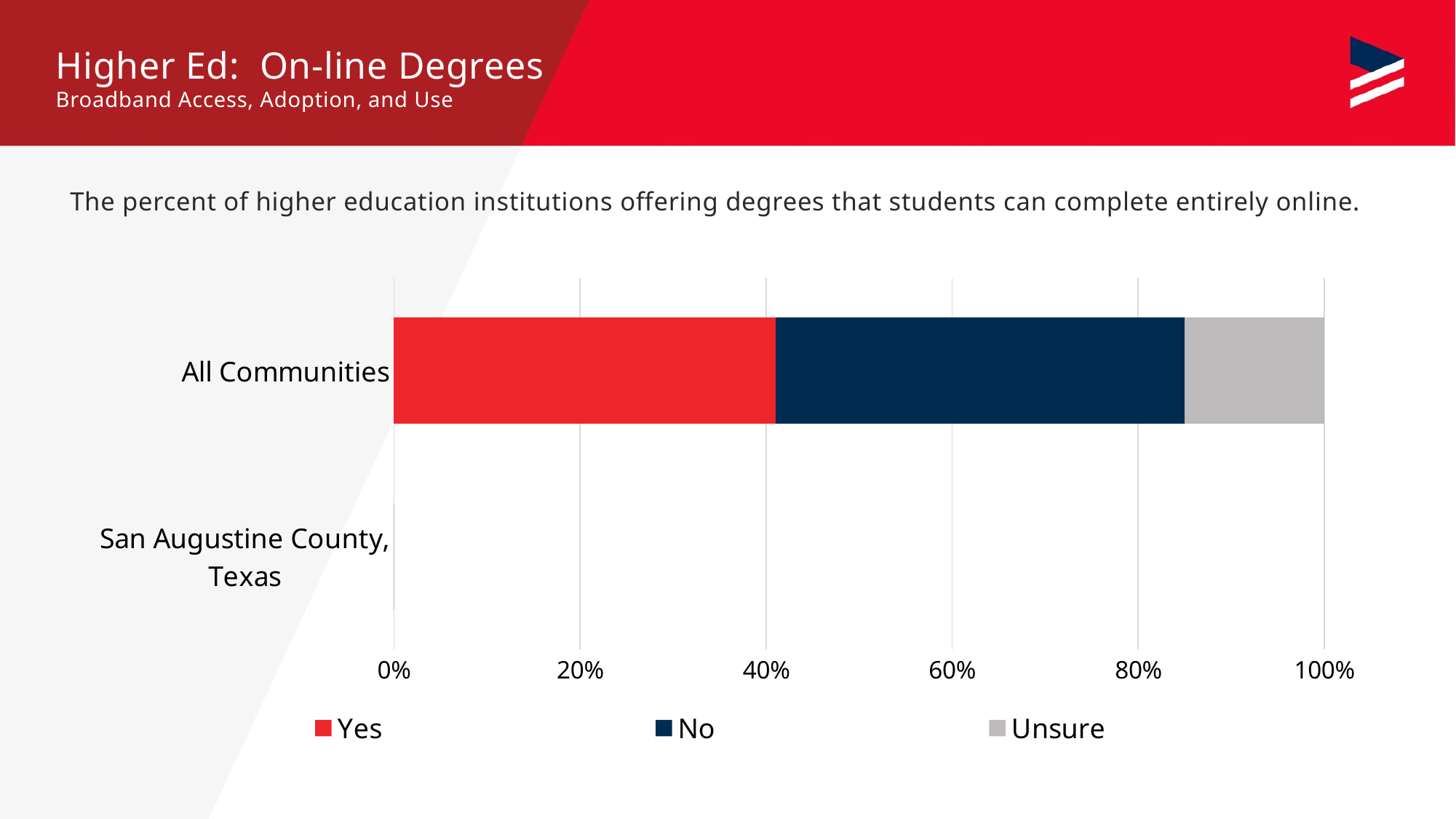
What kind of chart is shown on the slide? bar chart How many categories are shown on the vertical axis? 2 Is the Yes value for All Communities greater or less than 60%? less How many series does the legend list? 3 What is the total of the stacked bar for All Communities? 100% Which category has no bar plotted? San Augustine County, Texas For All Communities, which is larger, the No segment or the Unsure segment? No For All Communities, which response has the smallest segment? Unsure Is the Yes value for All Communities greater or less than 20%? greater For All Communities, which is larger, the Yes segment or the Unsure segment? Yes Is the Unsure value for All Communities greater or less than 20%? less What are the series listed in the legend? Yes, No, Unsure